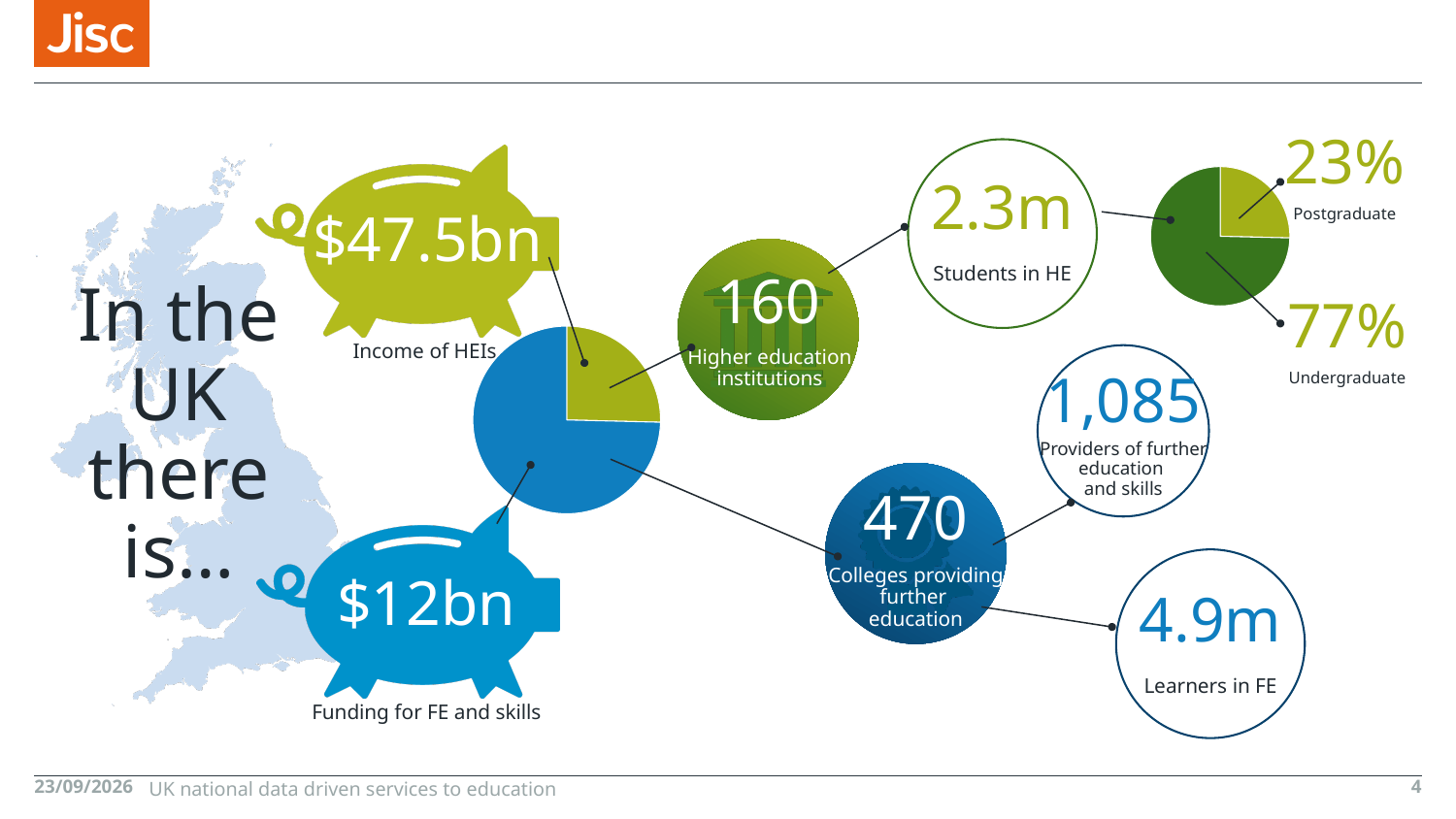
On the pie chart on the right of the slide, which category has the smaller share? Postgraduate On the pie chart on the right of the slide, what is the difference in percentage points between Undergraduate and Postgraduate? 54 On the pie chart on the right of the slide, what percentage is Postgraduate? 23% On the pie chart on the right of the slide, what do the Postgraduate and Undergraduate shares add up to? 100% On the pie chart on the right of the slide, which category has the larger share? Undergraduate What kind of chart is shown on the right of the slide next to the Postgraduate and Undergraduate labels? pie chart On the pie chart on the right of the slide, what percentage is Undergraduate? 77% On the pie chart on the right of the slide, is the Postgraduate share larger or smaller than the Undergraduate share? smaller On the pie chart in the centre of the slide, which colour slice is larger, blue or green? blue On the pie chart in the centre of the slide, how many slices are there? 2 On the pie chart on the right of the slide, how many slices are there? 2 What kind of chart is shown in the centre of the slide between the two piggy banks? pie chart